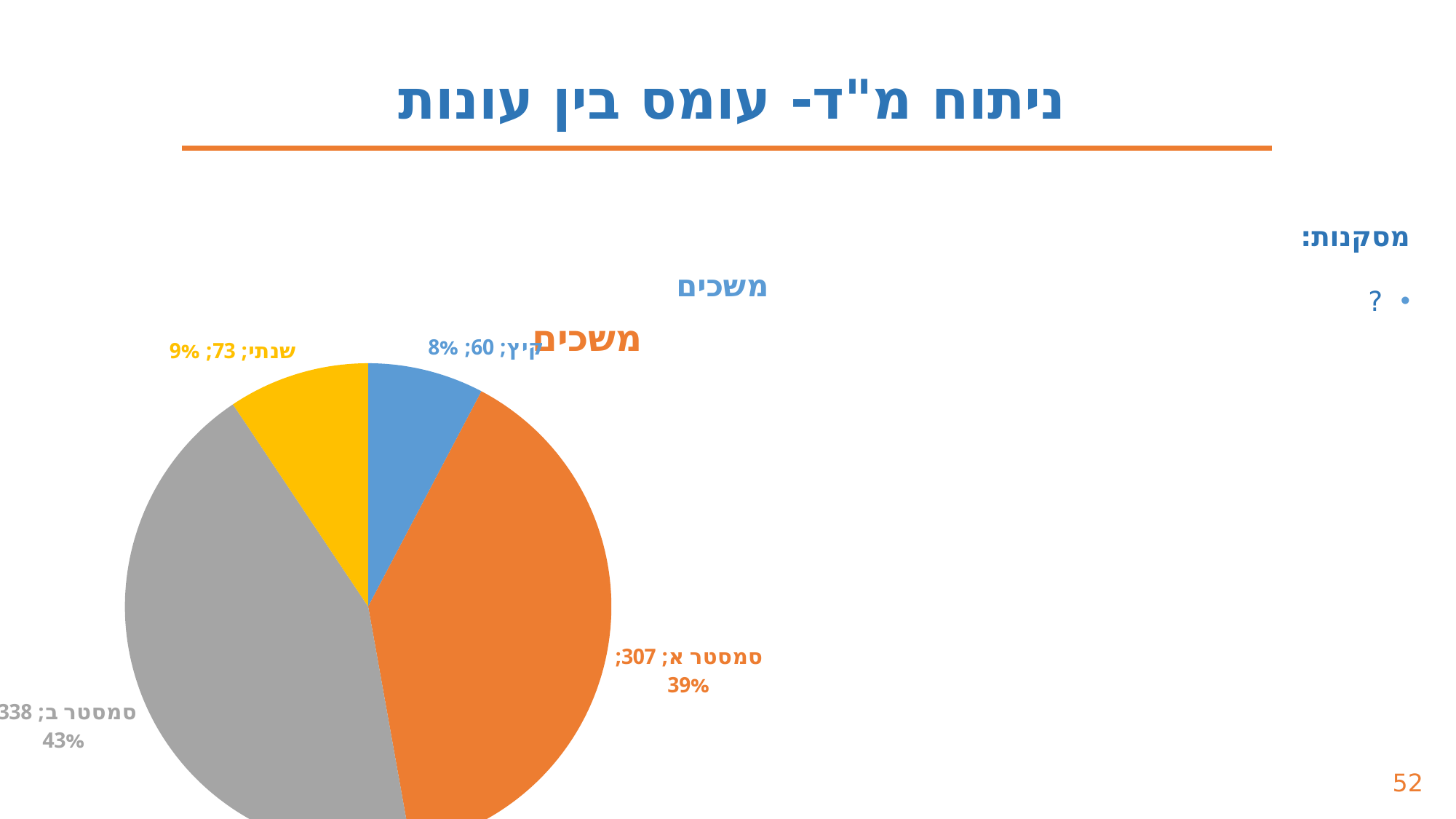
What share of the pie does קיץ represent? 8% How many slices does the pie chart have? 4 What is the value for סמסטר ב in the pie chart? 338 What is the value for שנתי in the pie chart? 73 What share of the pie does סמסטר ב represent? 43% What kind of chart is shown on the slide? pie chart What is the value for קיץ in the pie chart? 60 Which category has the largest slice in the pie chart? סמסטר ב What is the title of the pie chart? משכים What is the difference between the values for סמסטר ב and סמסטר א? 31 Which category has the smallest slice in the pie chart? קיץ What is the value for סמסטר א in the pie chart? 307